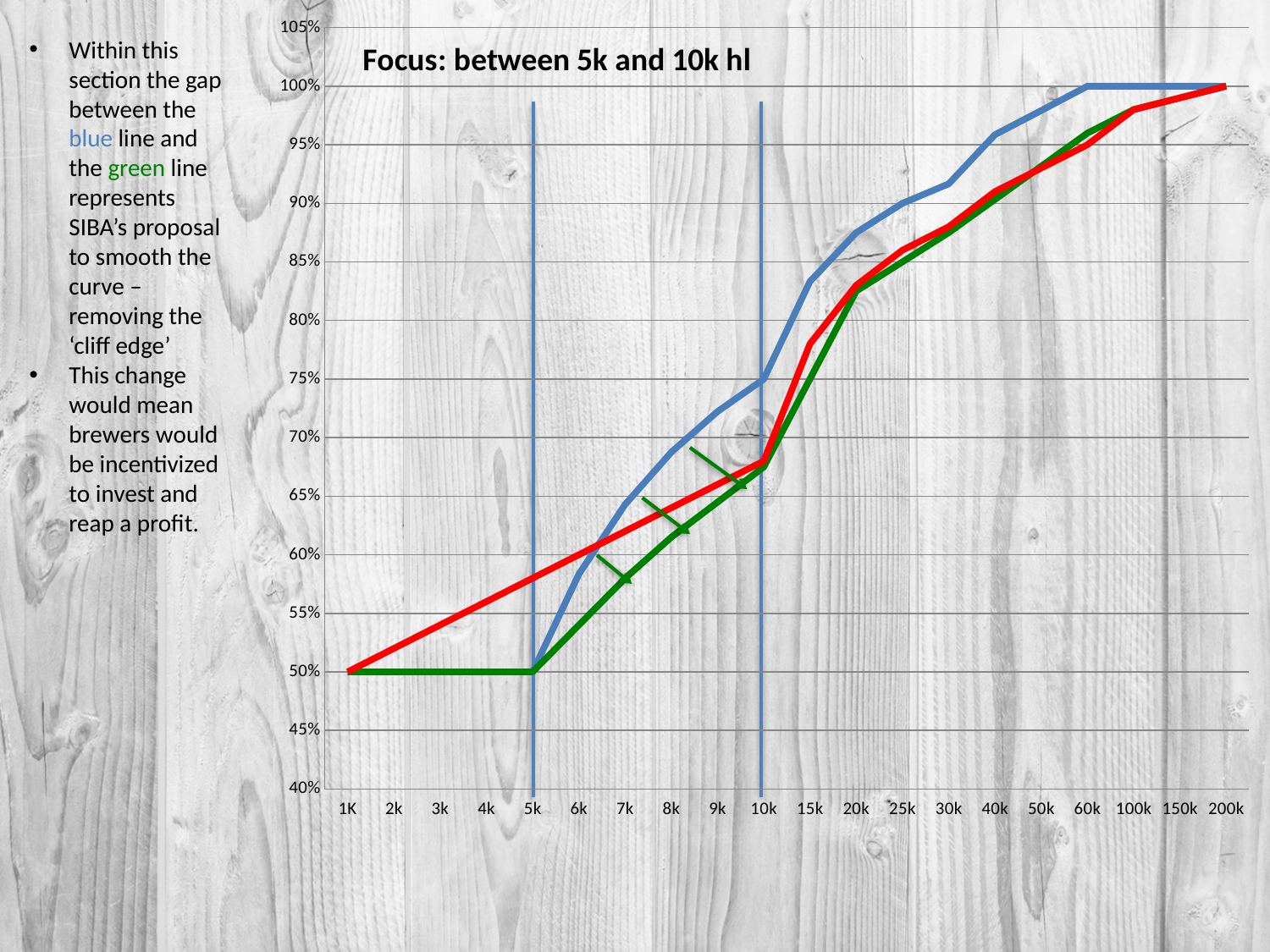
What kind of chart is shown on the slide? line chart How many categories are shown on the x axis of the chart? 20 At 8k, which line has the higher value, the blue line or the green line? blue line Do the values of the blue line rise or fall as you move from 5k to 200k along the x axis? rise Is the value of the blue line at 10k greater or less than 70%? greater Is the value of the blue line at 15k greater or less than 80%? greater What is the value of the blue line at 60k? 100% What is the title shown on the chart? Focus: between 5k and 10k hl What is the value of the green line at 1K? 50% Is the value of the green line at 7k greater or less than 60%? less What is the value of the blue line at 5k? 50% What is the value of the red line at 200k? 100%